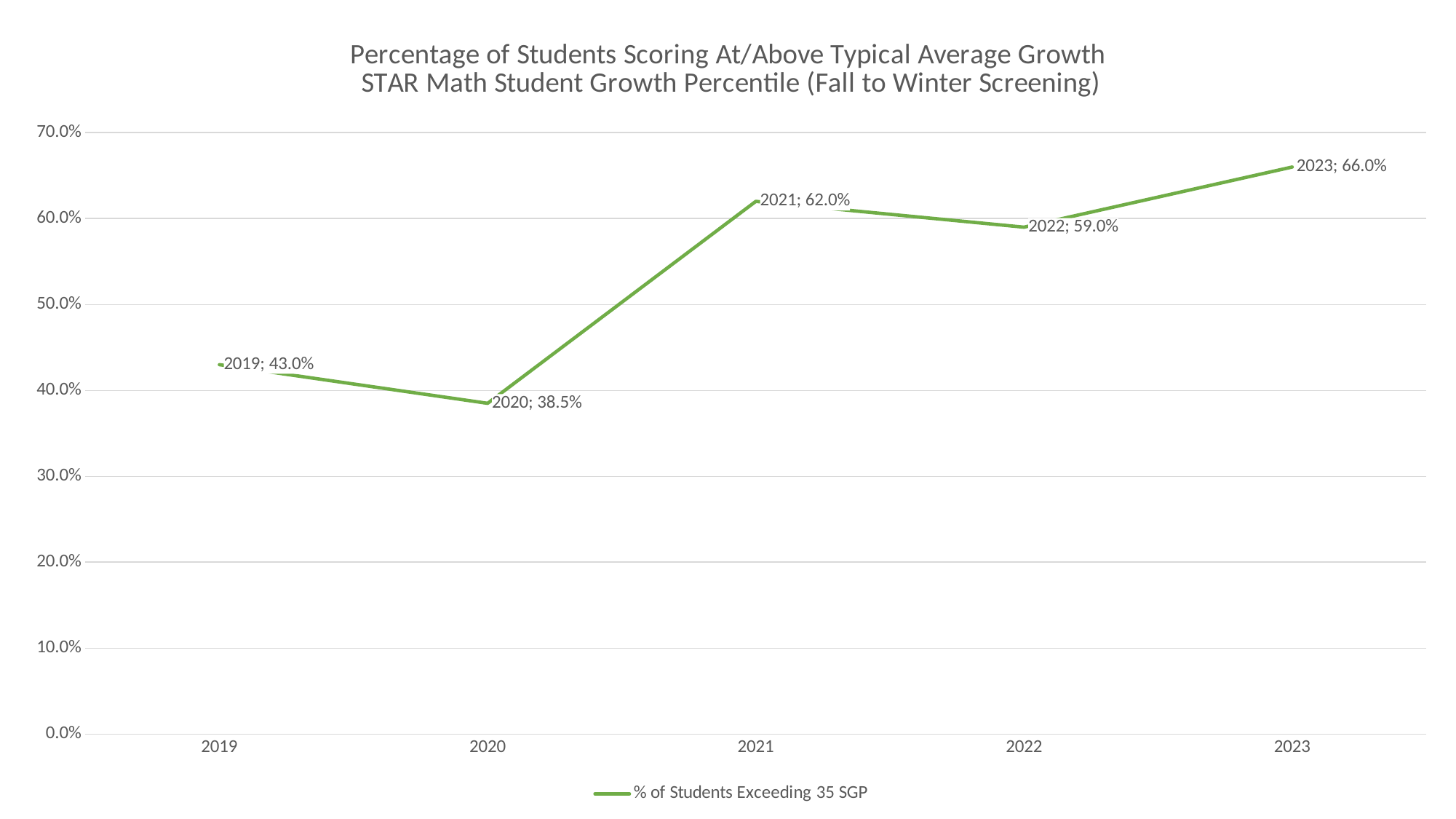
What series name does the legend show? % of Students Exceeding 35 SGP Which year has the lowest value? 2020 What is the value for 2022? 59.0% How many years are plotted on the chart? 5 What is the difference between the values for 2023 and 2020? 27.5% What is the value for 2019? 43.0% What kind of chart is shown? line chart What is the difference between the values for 2021 and 2022? 3.0% Which is larger, the value for 2021 or the value for 2022? 2021 Is the value for 2020 greater or less than 40.0%? less What is the value for 2020? 38.5% Which year has the highest value? 2023